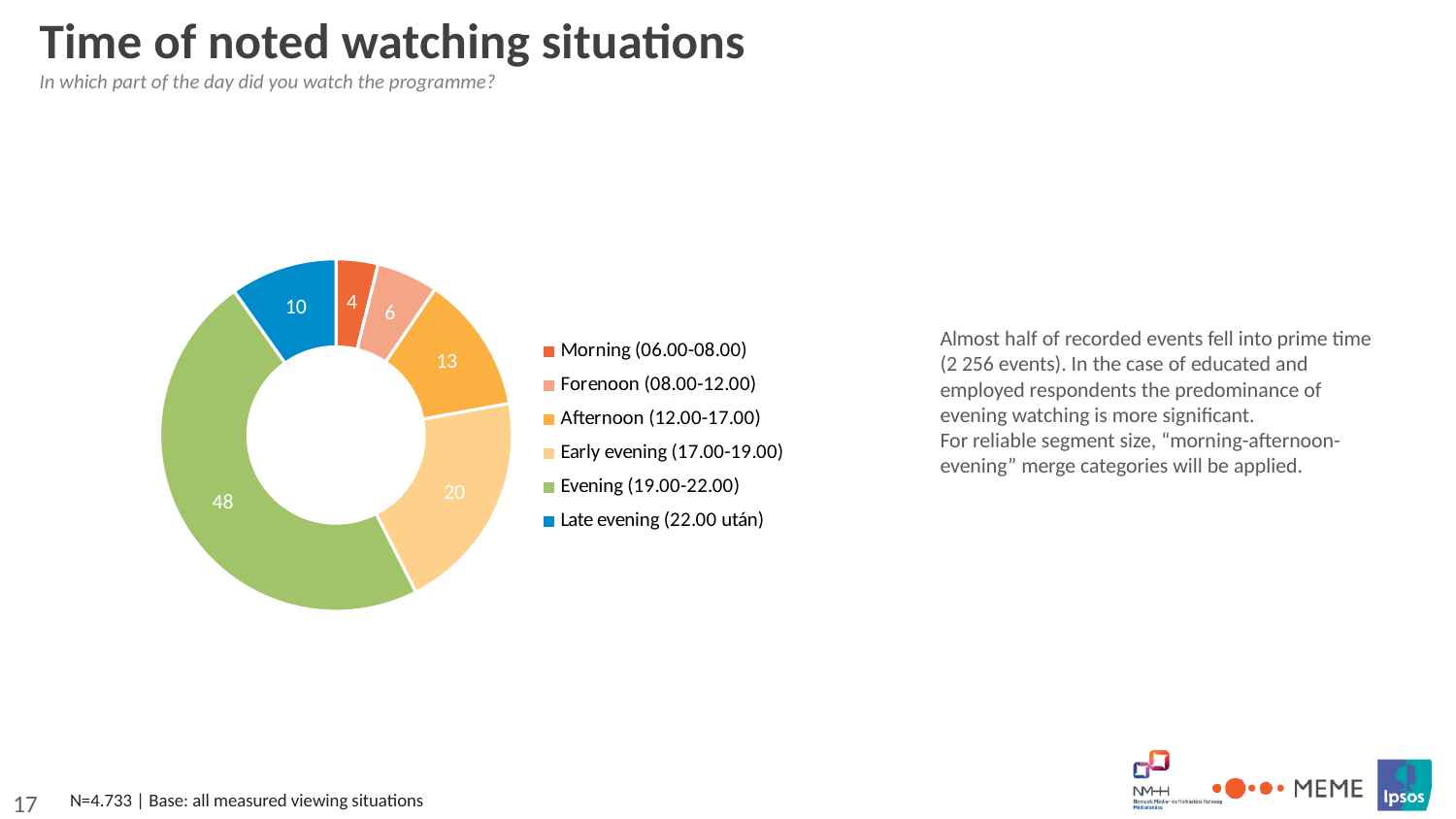
How many categories does the chart show? 6 What is the difference between the values for Afternoon (12.00-17.00) and Forenoon (08.00-12.00)? 7 What is the value for Late evening (22.00 után)? 10 What colour is the Evening (19.00-22.00) segment? Green Which category has the largest value? Evening (19.00-22.00) What kind of chart is shown on the slide? Doughnut chart Which is larger, the value for Afternoon (12.00-17.00) or the value for Late evening (22.00 után)? Afternoon (12.00-17.00) What is the value for Evening (19.00-22.00)? 48 What is the difference between the values for Evening (19.00-22.00) and Early evening (17.00-19.00)? 28 Which category has the smallest value? Morning (06.00-08.00) What is the value for Early evening (17.00-19.00)? 20 What is the value for Morning (06.00-08.00)? 4